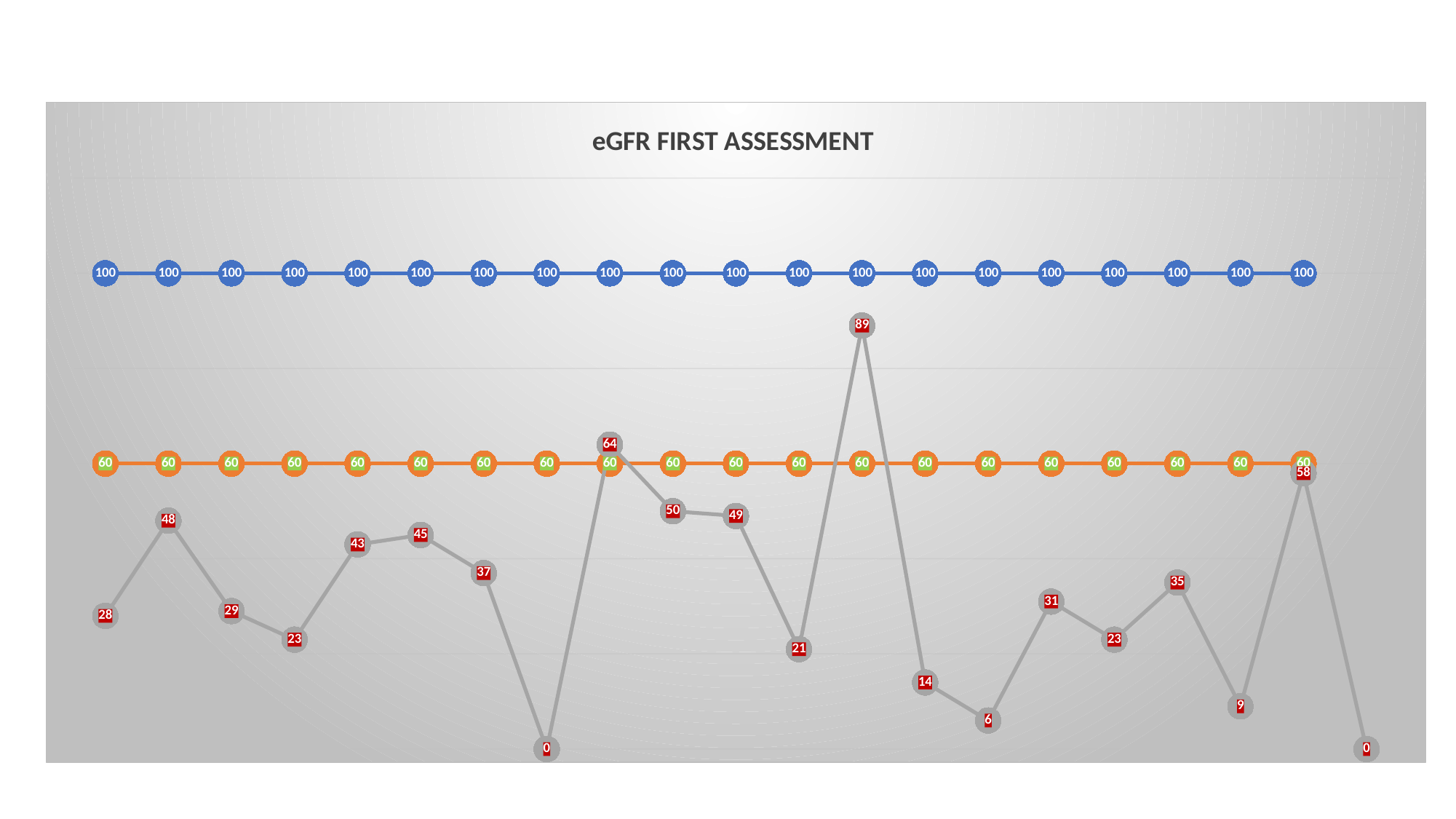
What constant value does the orange line show at every point? 60 What is the difference between the highest grey value (89) and the orange line value (60)? 29 What is the highest value on the grey line? 89 What constant value does the blue line show at every point? 100 How many lines are plotted in the chart? 3 What is the value of the first point on the grey line? 28 How many data points does each line in the chart have? The blue and orange lines have 20 points each; the grey line has 21 What is the lowest value on the grey line? 0 What kind of chart is shown on the slide? line chart What is the title of the chart? eGFR FIRST ASSESSMENT Which is larger on the grey line: the second point or the third point? the second point (48) What is the value of the second point on the grey line? 48